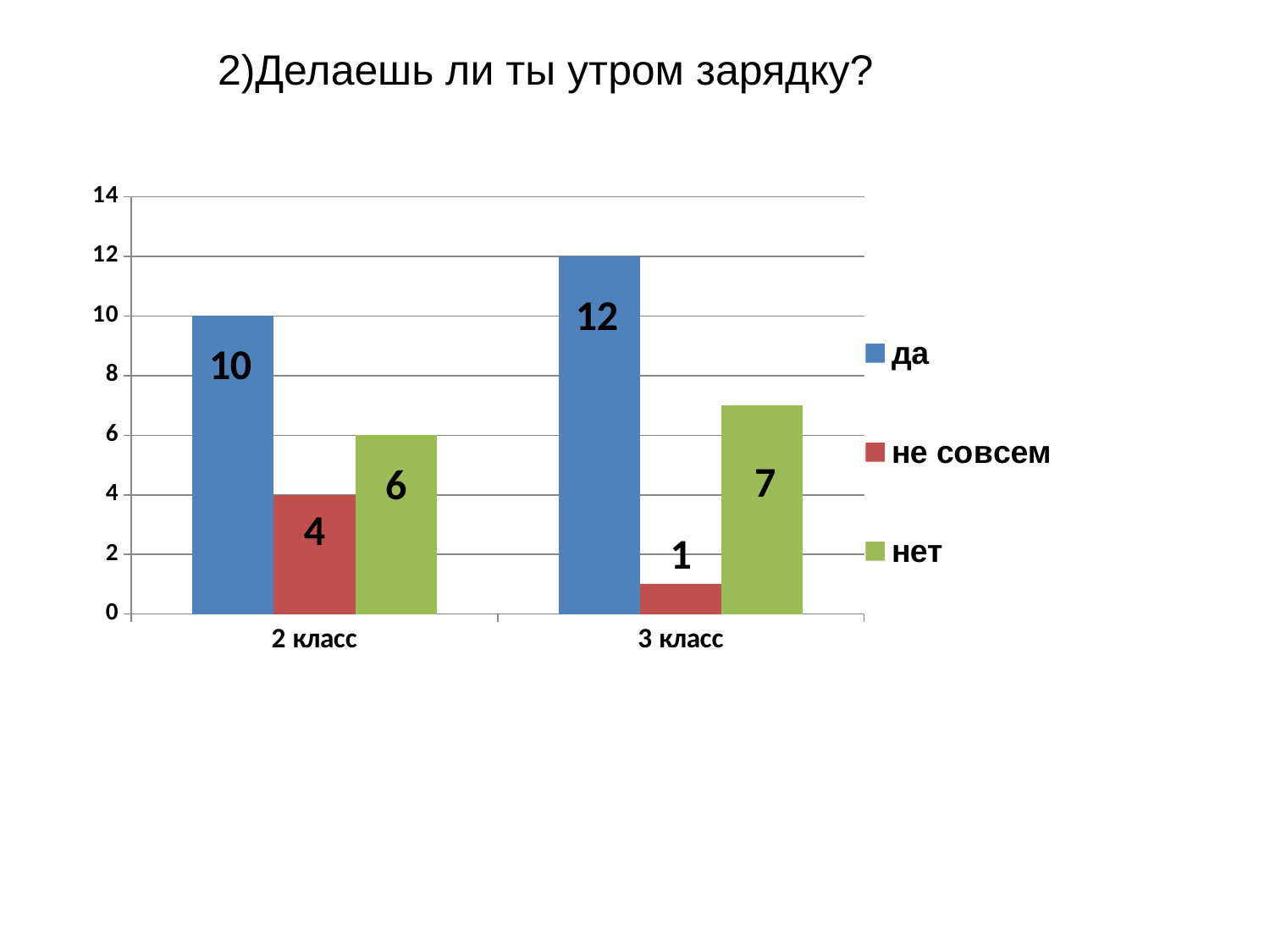
Which is larger: "нет" in 2 класс or "нет" in 3 класс? 3 класс Is the value for "да" in 3 класс greater or less than 10? greater What kind of chart is shown on the slide? bar chart What is the value for "нет" in 3 класс? 7 What is the value for "не совсем" in 3 класс? 1 What colour are the bars for the "нет" series? green How many categories are shown on the x axis? 2 What is the difference between the "да" values for 3 класс and 2 класс? 2 Which series has the highest value in 3 класс? да What is the value for "да" in 2 класс? 10 How many series does the legend list? 3 Which series has the lowest value in 2 класс? не совсем